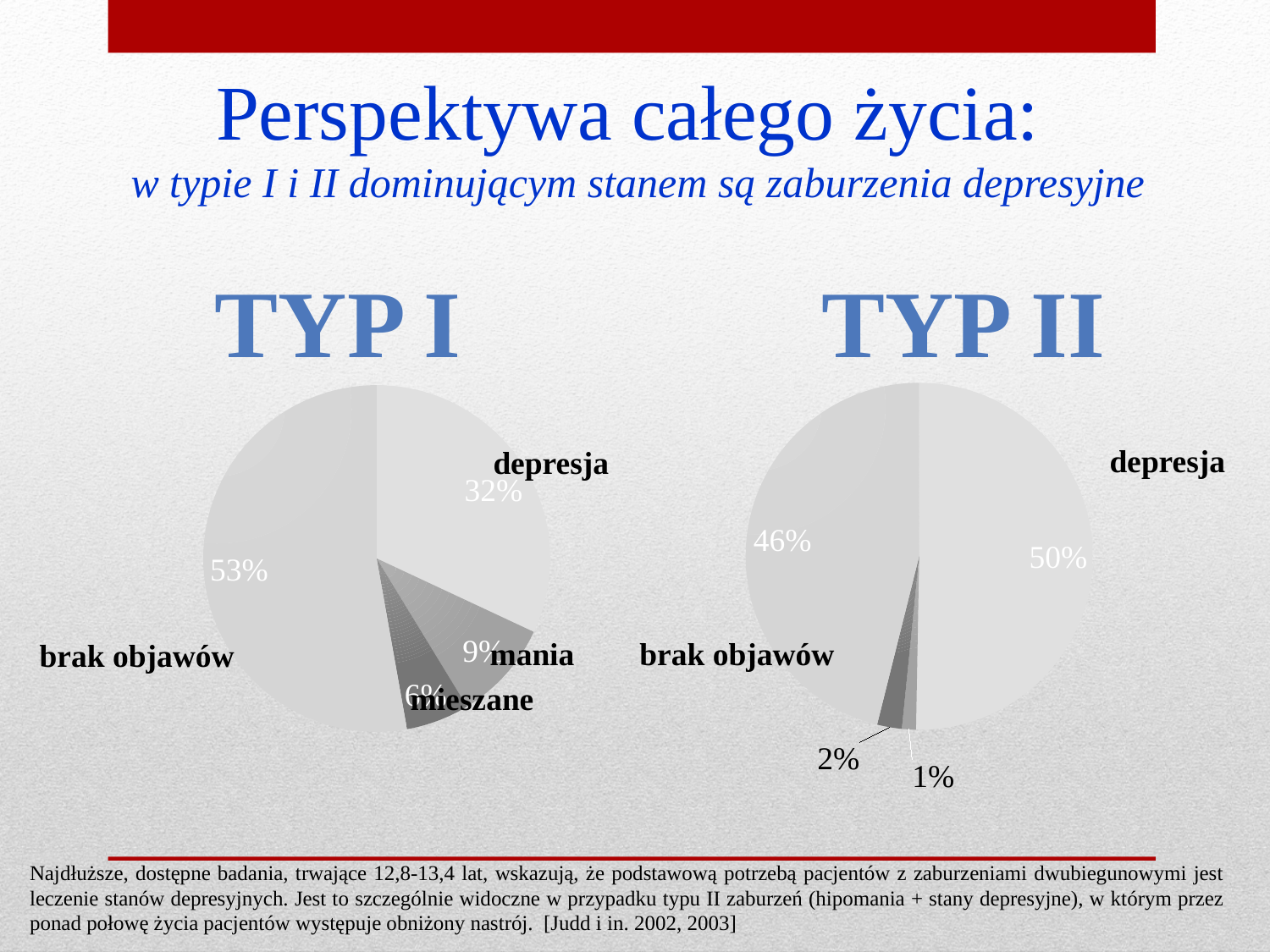
In the TYP I chart, what share of the pie is labelled brak objawów? 53% In the TYP I chart, what is the value for mieszane? 6% How many slices does the TYP II pie chart have? 4 In the TYP II chart, which is larger, depresja or brak objawów? depresja In the TYP I chart, which category has the smallest slice? mieszane In the TYP I chart, what is the difference between brak objawów and depresja? 21% In the TYP I chart, what share of the pie is labelled depresja? 32% In the TYP II chart, what share of the pie is labelled brak objawów? 46% In the TYP II chart, what share of the pie is labelled depresja? 50% In the TYP I chart, which category has the largest slice? brak objawów In the TYP I chart, what is the value for mania? 9% What type of chart is used for TYP I? pie chart